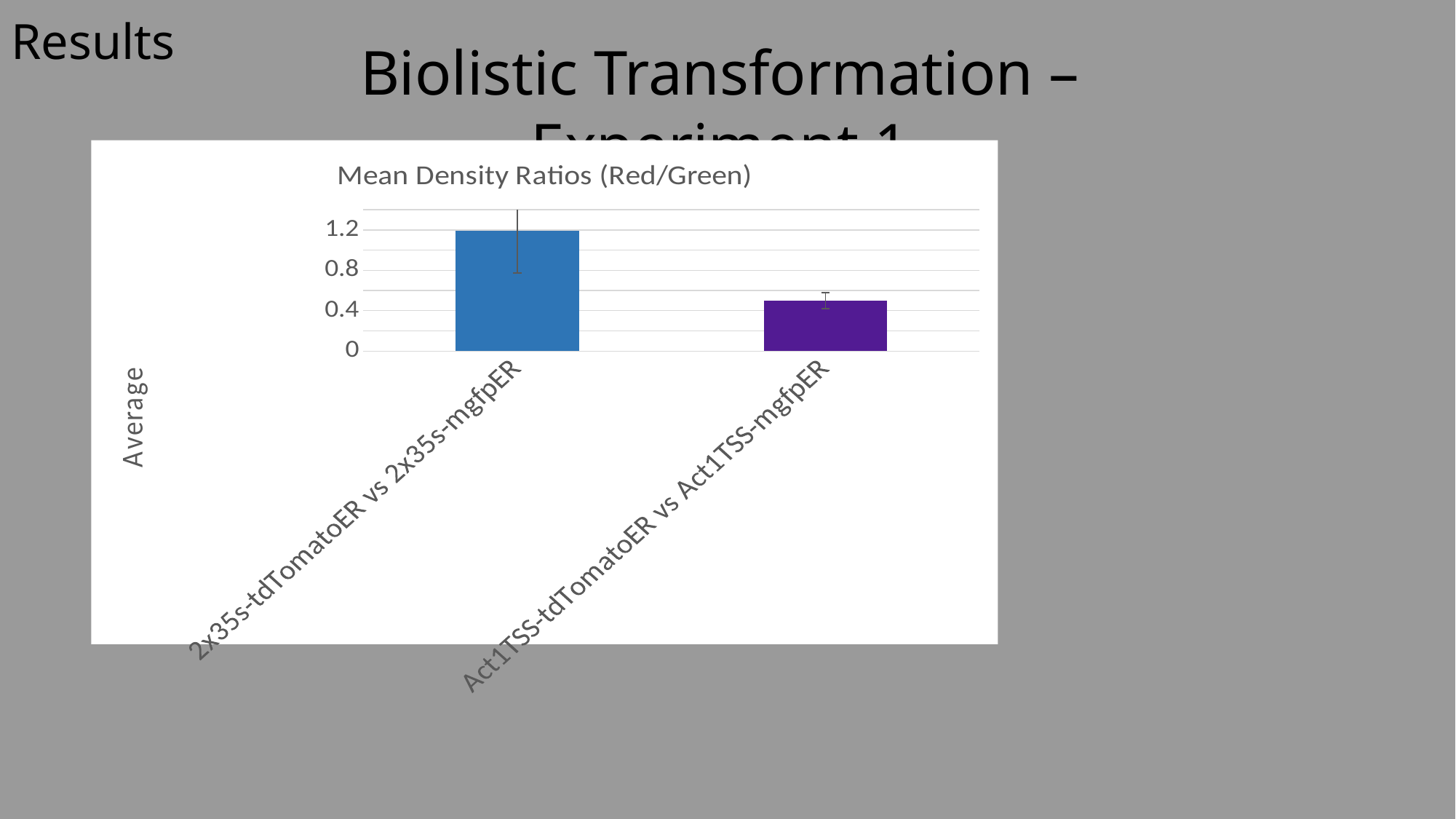
Is the value for Act1TSS-tdTomatoER vs Act1TSS-mgfpER greater or less than 0.4? greater Which is larger: the value for 2x35s-tdTomatoER vs 2x35s-mgfpER or the value for Act1TSS-tdTomatoER vs Act1TSS-mgfpER? 2x35s-tdTomatoER vs 2x35s-mgfpER Which category has the lowest mean density ratio? Act1TSS-tdTomatoER vs Act1TSS-mgfpER Is the value for Act1TSS-tdTomatoER vs Act1TSS-mgfpER greater or less than 0.8? less What is the title of the chart? Mean Density Ratios (Red/Green) Is the value for 2x35s-tdTomatoER vs 2x35s-mgfpER greater or less than 0.8? greater Which category has the highest mean density ratio? 2x35s-tdTomatoER vs 2x35s-mgfpER What type of chart is shown on the slide? Bar chart How many categories are plotted in the chart? 2 Do the values rise or fall from the left category to the right category? Fall What is the label on the vertical axis of the chart? Average